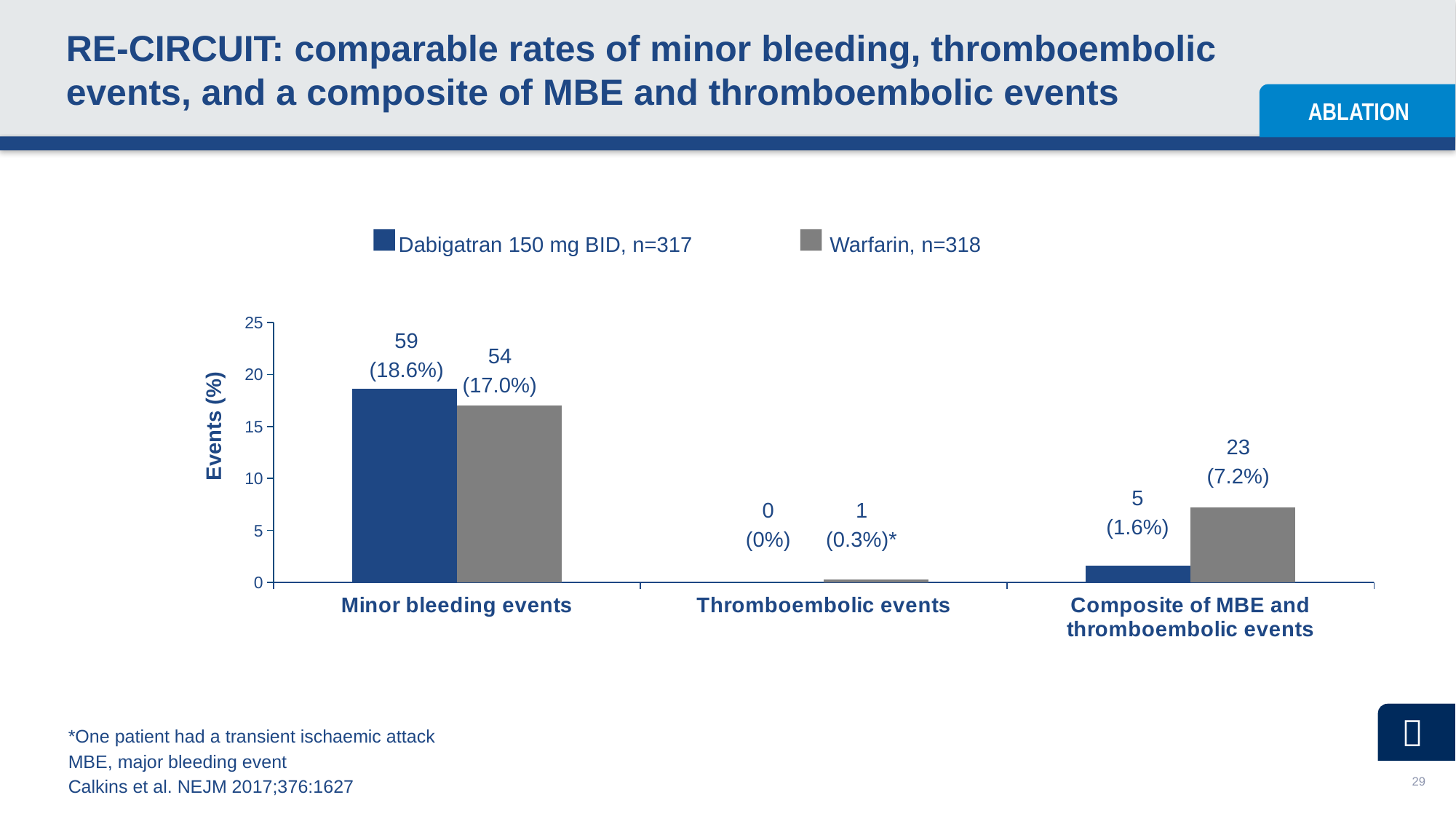
How many series does the legend list? 2 What is the difference in the number of minor bleeding events between Dabigatran 150 mg BID and Warfarin? 5 Is the Warfarin value for minor bleeding events greater or less than 15? greater How many categories are shown on the x axis? 3 What is the percentage of minor bleeding events for Dabigatran 150 mg BID? 18.6% How many thromboembolic events occurred in the Dabigatran 150 mg BID group? 0 Which category has the highest event rate for Warfarin? Minor bleeding events What is the percentage for the composite of MBE and thromboembolic events in the Warfarin group? 7.2% Which treatment has the higher rate for the composite of MBE and thromboembolic events? Warfarin Which category has the lowest event rate for Dabigatran 150 mg BID? Thromboembolic events How many minor bleeding events occurred in the Warfarin group? 54 What kind of chart is shown on the slide? Bar chart